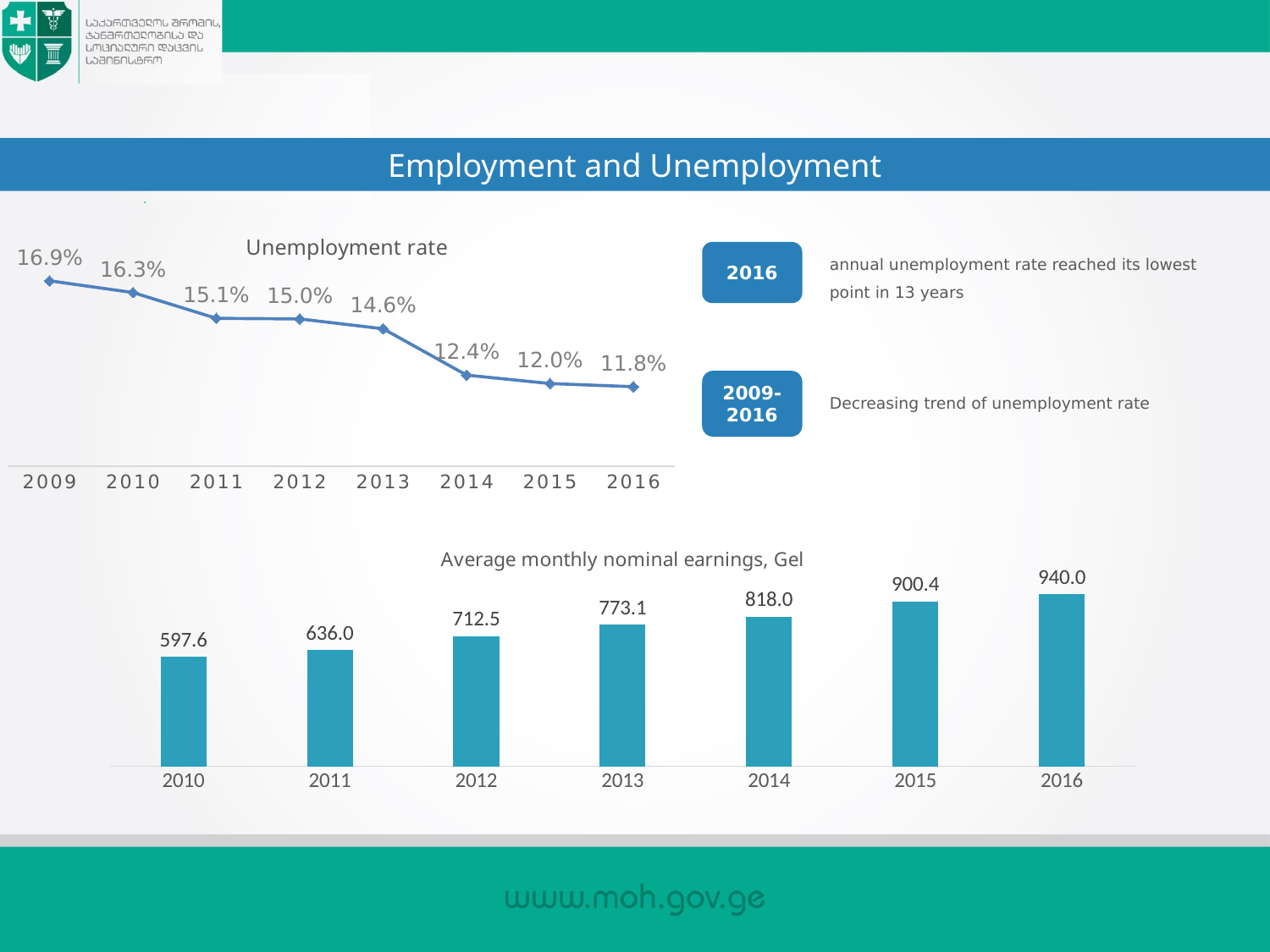
In the Unemployment rate chart, what was the unemployment rate in 2009? 16.9% In the Average monthly nominal earnings chart, how many bars are shown? 7 In the Unemployment rate chart, how many years are plotted? 8 What kind of chart is the Average monthly nominal earnings chart? bar chart In the Unemployment rate chart, do the values rise or fall from 2009 to 2016? fall In the Unemployment rate chart, which year has the lowest unemployment rate? 2016 In the Average monthly nominal earnings chart, which is larger, the value for 2012 or the value for 2011? 2012 In the Average monthly nominal earnings chart, what is the value for 2013? 773.1 In the Average monthly nominal earnings chart, what is the difference between the 2016 and 2010 values? 342.4 In the Average monthly nominal earnings chart, which year has the highest value? 2016 In the Unemployment rate chart, what was the unemployment rate in 2014? 12.4% What kind of chart is the Unemployment rate chart? line chart